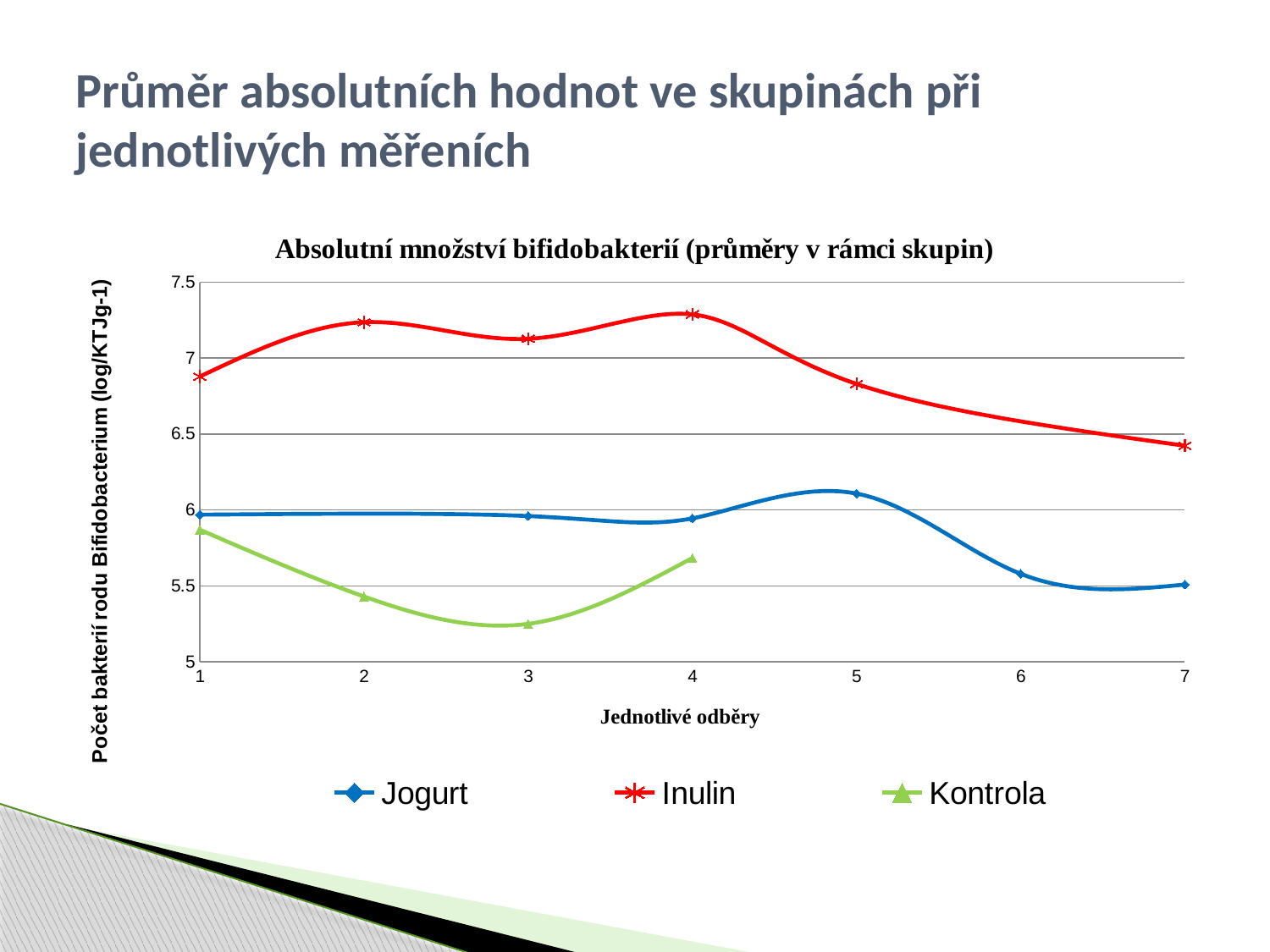
What kind of chart is shown on the slide? line chart At which sampling point does the Kontrola series reach its lowest value? 3 Does the Inulin series rise or fall from sampling point 4 to sampling point 7? fall Is the value for Jogurt at sampling point 5 greater or less than 6? greater At sampling point 4, which series has the larger value, Inulin or Jogurt? Inulin Is the value for Inulin at sampling point 2 greater or less than 7? greater Is the value for Inulin at sampling point 7 greater or less than 6.5? less How many series does the legend list? 3 How many sampling points (odběry) are shown on the x axis? 7 How many data points does the Kontrola series have? 4